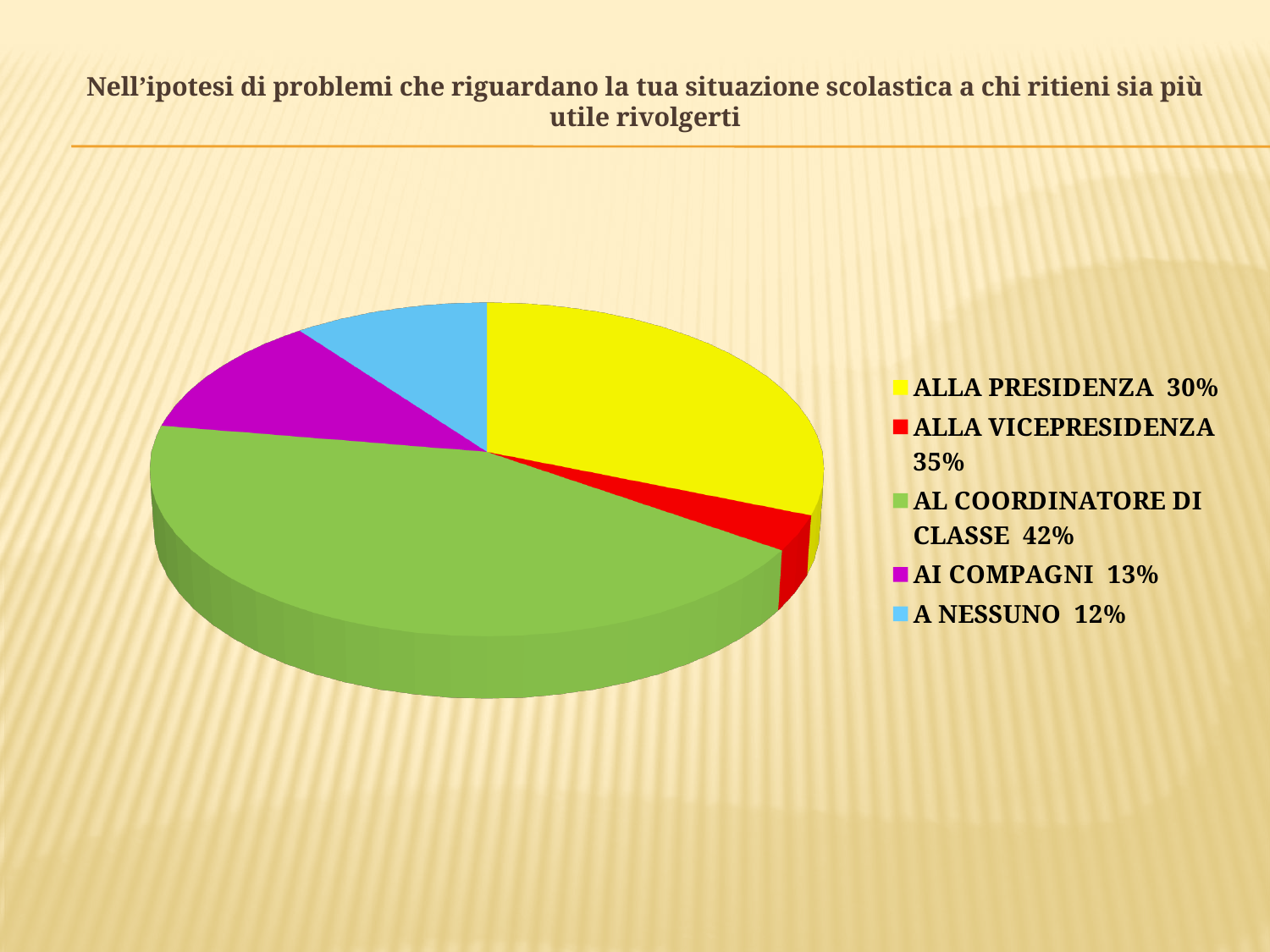
Which category has the largest share of the pie? AL COORDINATORE DI CLASSE By how many percentage points does AL COORDINATORE DI CLASSE exceed ALLA PRESIDENZA? 12 percentage points What percentage is shown for AL COORDINATORE DI CLASSE? 42% Which has the larger share, ALLA PRESIDENZA or AI COMPAGNI? ALLA PRESIDENZA What percentage is shown for AI COMPAGNI? 13% What colour is the slice for A NESSUNO? Light blue What percentage is shown for ALLA PRESIDENZA? 30% Which has the larger share, ALLA PRESIDENZA or A NESSUNO? ALLA PRESIDENZA How many categories does the pie chart have? 5 What kind of chart is shown on the slide? Pie chart What percentage is shown for A NESSUNO? 12% What colour is the slice for AL COORDINATORE DI CLASSE? Green